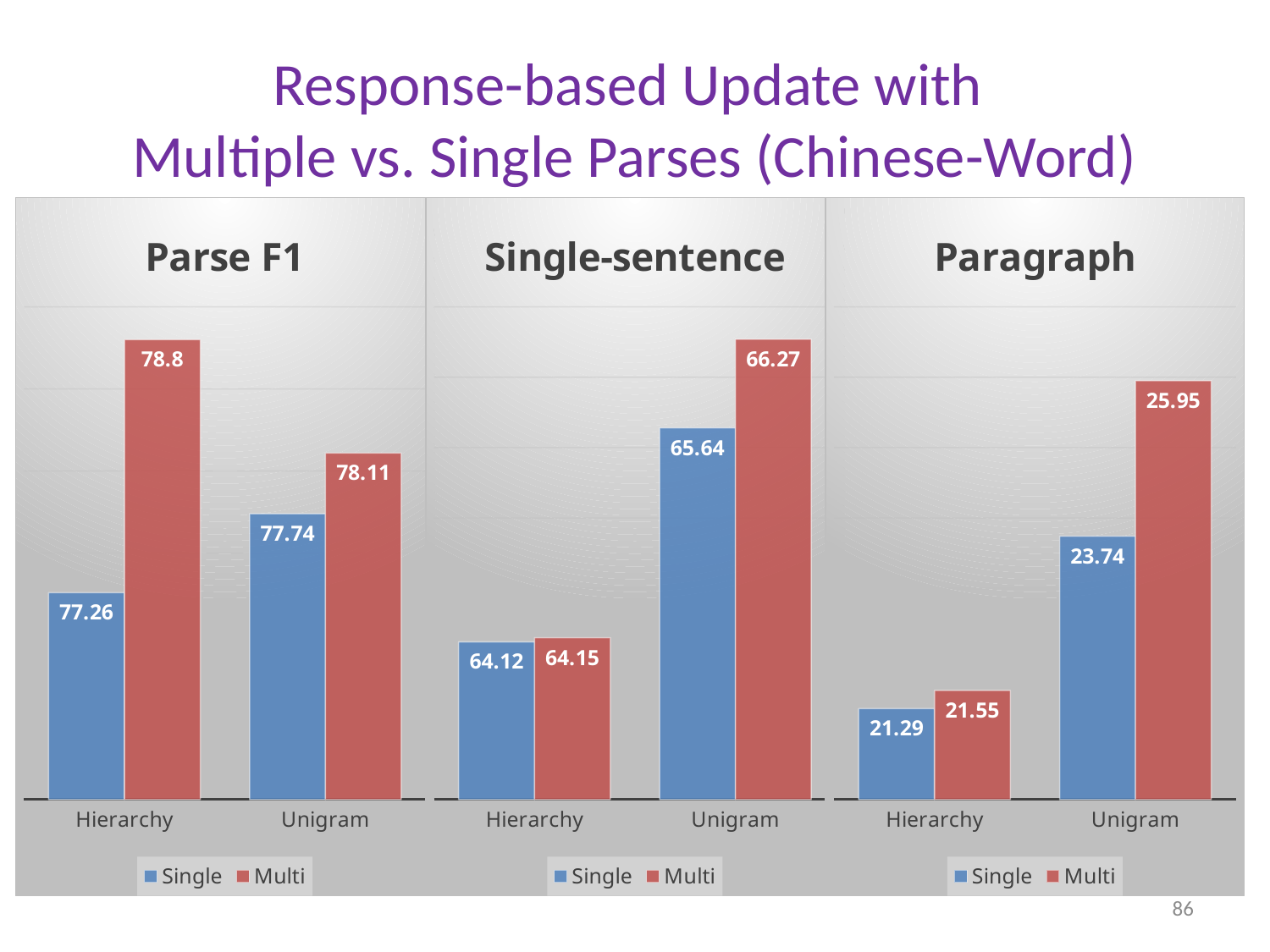
In the Paragraph chart, what is the value for Single under Hierarchy? 21.29 In the Single-sentence chart, which is larger under Unigram, Single or Multi? Multi What kind of chart is the Single-sentence chart? Bar chart How many series does the legend of the Parse F1 chart list? 2 In the Parse F1 chart, what is the value for Multi under Hierarchy? 78.8 In the Paragraph chart, what is the difference between Multi and Single under Unigram? 2.21 In the Parse F1 chart, what is the value for Single under Unigram? 77.74 How many categories are shown on the x axis of the Paragraph chart? 2 In the Parse F1 chart, what is the difference between Multi and Single under Hierarchy? 1.54 In the Paragraph chart, which bar has the highest value? Multi under Unigram In the Single-sentence chart, which bar has the lowest value? Single under Hierarchy In the Single-sentence chart, what is the value for Multi under Unigram? 66.27